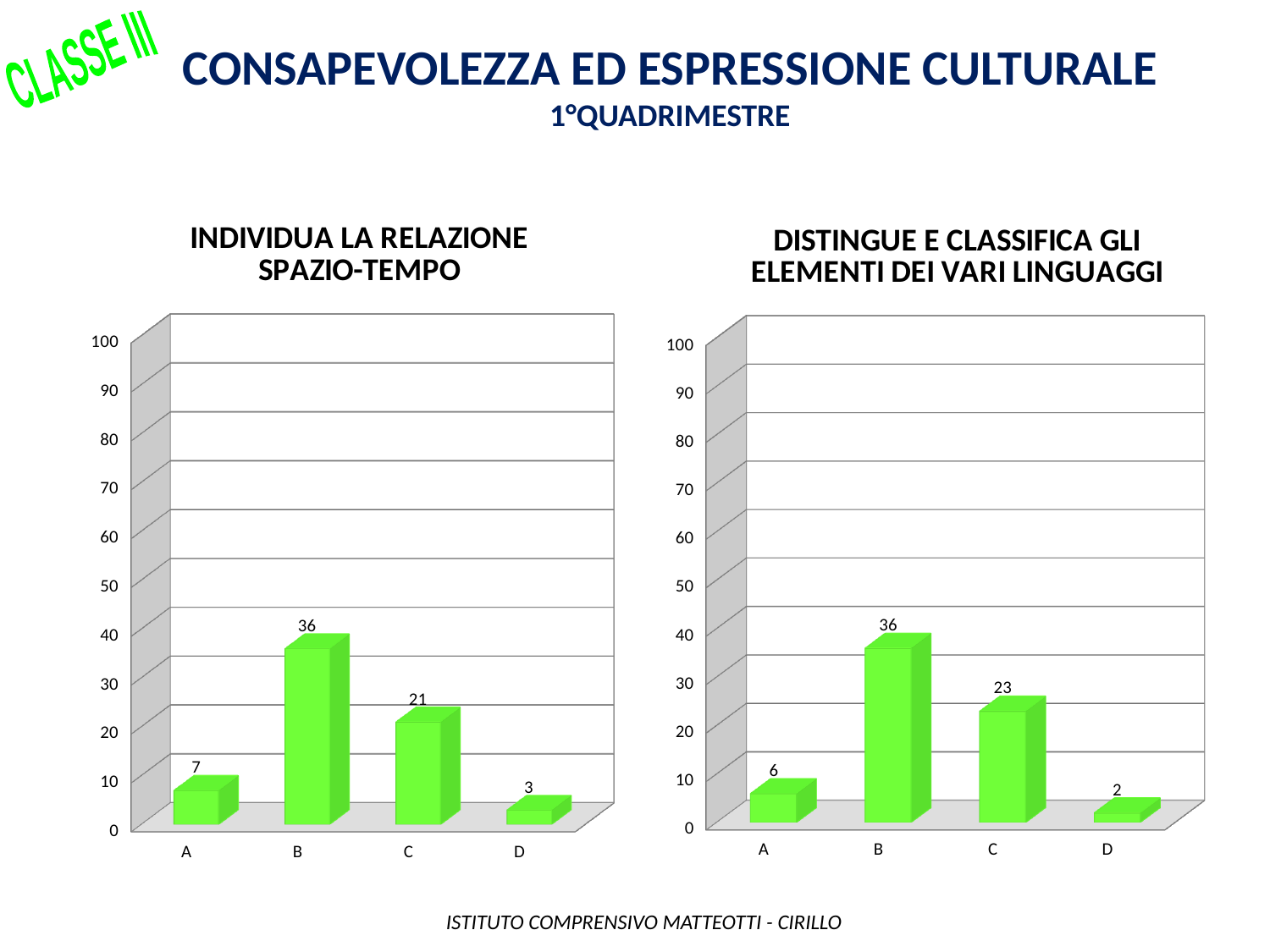
In the chart titled 'INDIVIDUA LA RELAZIONE SPAZIO-TEMPO', what is the value for category B? 36 In the chart titled 'INDIVIDUA LA RELAZIONE SPAZIO-TEMPO', which is larger, the value for A or the value for C? C In the chart titled 'INDIVIDUA LA RELAZIONE SPAZIO-TEMPO', what is the difference between the values for B and C? 15 In the chart titled 'DISTINGUE E CLASSIFICA GLI ELEMENTI DEI VARI LINGUAGGI', what is the value for category C? 23 In the chart titled 'DISTINGUE E CLASSIFICA GLI ELEMENTI DEI VARI LINGUAGGI', what is the difference between the values for B and A? 30 In the chart titled 'DISTINGUE E CLASSIFICA GLI ELEMENTI DEI VARI LINGUAGGI', is the value for B greater or less than 30? greater In the chart titled 'DISTINGUE E CLASSIFICA GLI ELEMENTI DEI VARI LINGUAGGI', which category has the lowest value? D What kind of chart is the chart titled 'DISTINGUE E CLASSIFICA GLI ELEMENTI DEI VARI LINGUAGGI'? Bar chart In the chart titled 'INDIVIDUA LA RELAZIONE SPAZIO-TEMPO', what is the value for category D? 3 In the chart titled 'INDIVIDUA LA RELAZIONE SPAZIO-TEMPO', which category has the highest value? B How many categories are shown in the chart titled 'INDIVIDUA LA RELAZIONE SPAZIO-TEMPO'? 4 In the chart titled 'DISTINGUE E CLASSIFICA GLI ELEMENTI DEI VARI LINGUAGGI', what is the value for category A? 6